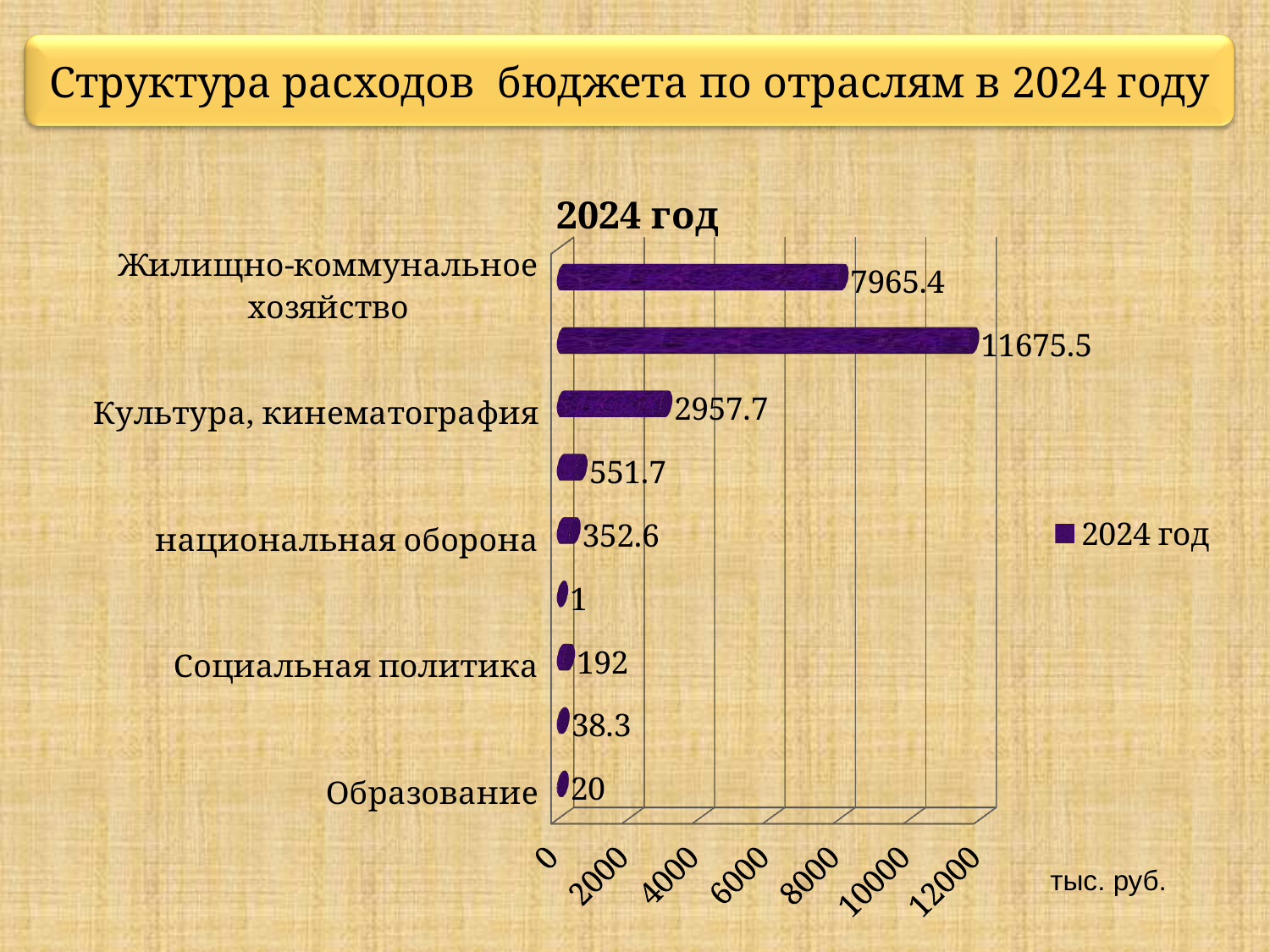
What is the value for национальная оборона? 352.6 Is the value for Жилищно-коммунальное хозяйство greater or less than 6000? greater What is the largest value shown on the chart? 11675.5 What is the difference between the values for Жилищно-коммунальное хозяйство and Культура, кинематография? 5007.7 What kind of chart is shown on the slide? bar chart What is the value for Жилищно-коммунальное хозяйство? 7965.4 What is the value for Культура, кинематография? 2957.7 What is the value for Социальная политика? 192 How many bars are plotted on the chart? 9 Which is larger, the value for Культура, кинематография or the value for национальная оборона? Культура, кинематография What is the value for Образование? 20 Among the labeled categories, which has the lowest value? Образование